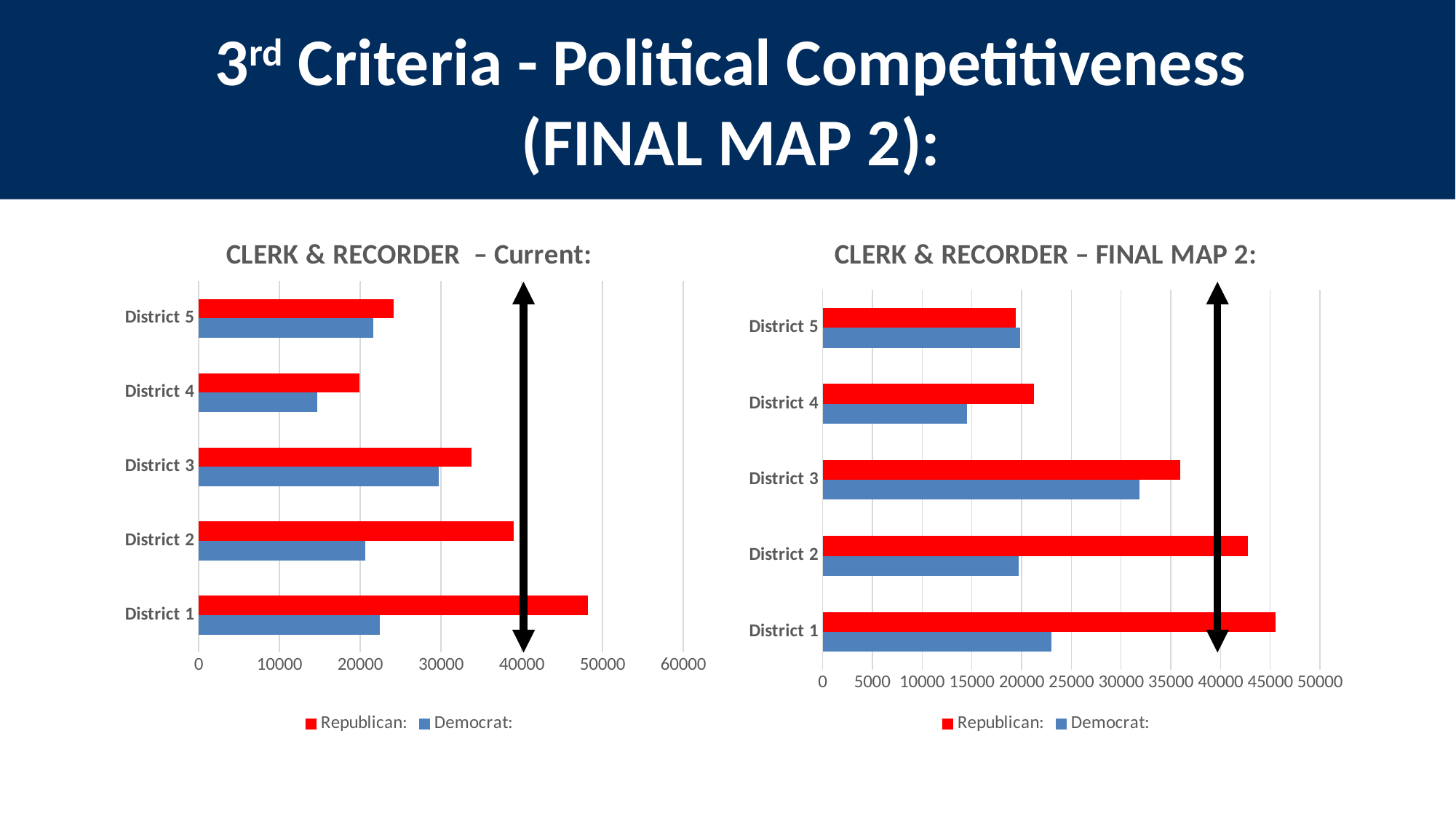
In the CLERK & RECORDER – Current chart, is the Republican value for District 1 greater or less than 40000? greater In the CLERK & RECORDER – Current chart, is the Democrat value for District 4 greater or less than 20000? less In the CLERK & RECORDER – Current chart, which district has the lowest Democrat value? District 4 In the CLERK & RECORDER – FINAL MAP 2 chart, is the Democrat value for District 3 greater or less than 30000? greater In the CLERK & RECORDER – Current chart, which is larger for District 2, the Republican or the Democrat value? Republican How many districts are shown in the CLERK & RECORDER – FINAL MAP 2 chart? 5 What kind of chart is the CLERK & RECORDER – FINAL MAP 2 chart? Bar chart In the CLERK & RECORDER – Current chart, which district has the highest Republican value? District 1 In the CLERK & RECORDER – FINAL MAP 2 chart, which district has the lowest Democrat value? District 4 How many series does the legend of the CLERK & RECORDER – Current chart list? 2 In the CLERK & RECORDER – FINAL MAP 2 chart, which district has the highest Republican value? District 1